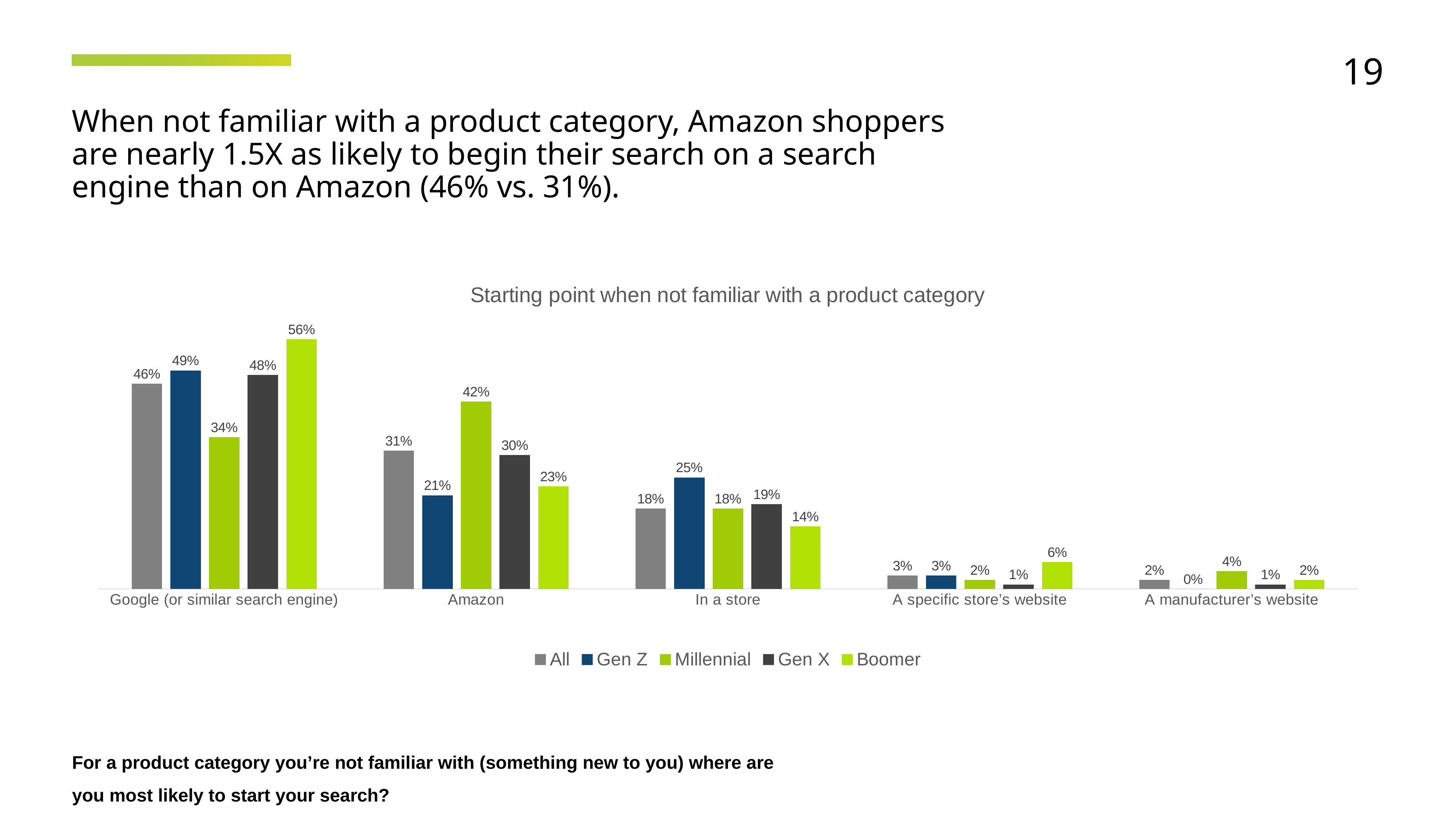
Which series has the lowest value in the Amazon category? Gen Z What kind of chart is shown on the slide? Bar chart Which series has the highest value in the Google (or similar search engine) category? Boomer How many series does the legend list? 5 What is the difference between the All values for Google (or similar search engine) and Amazon? 15% What is the title of the chart? Starting point when not familiar with a product category What is the value for Boomer in the Google (or similar search engine) category? 56% How many categories are shown on the x axis? 5 Which is larger for Millennial: the Google (or similar search engine) value or the Amazon value? Amazon What is the value for Gen Z in the In a store category? 25% What is the value for Gen Z in the A manufacturer's website category? 0% What is the value for Millennial in the Amazon category? 42%